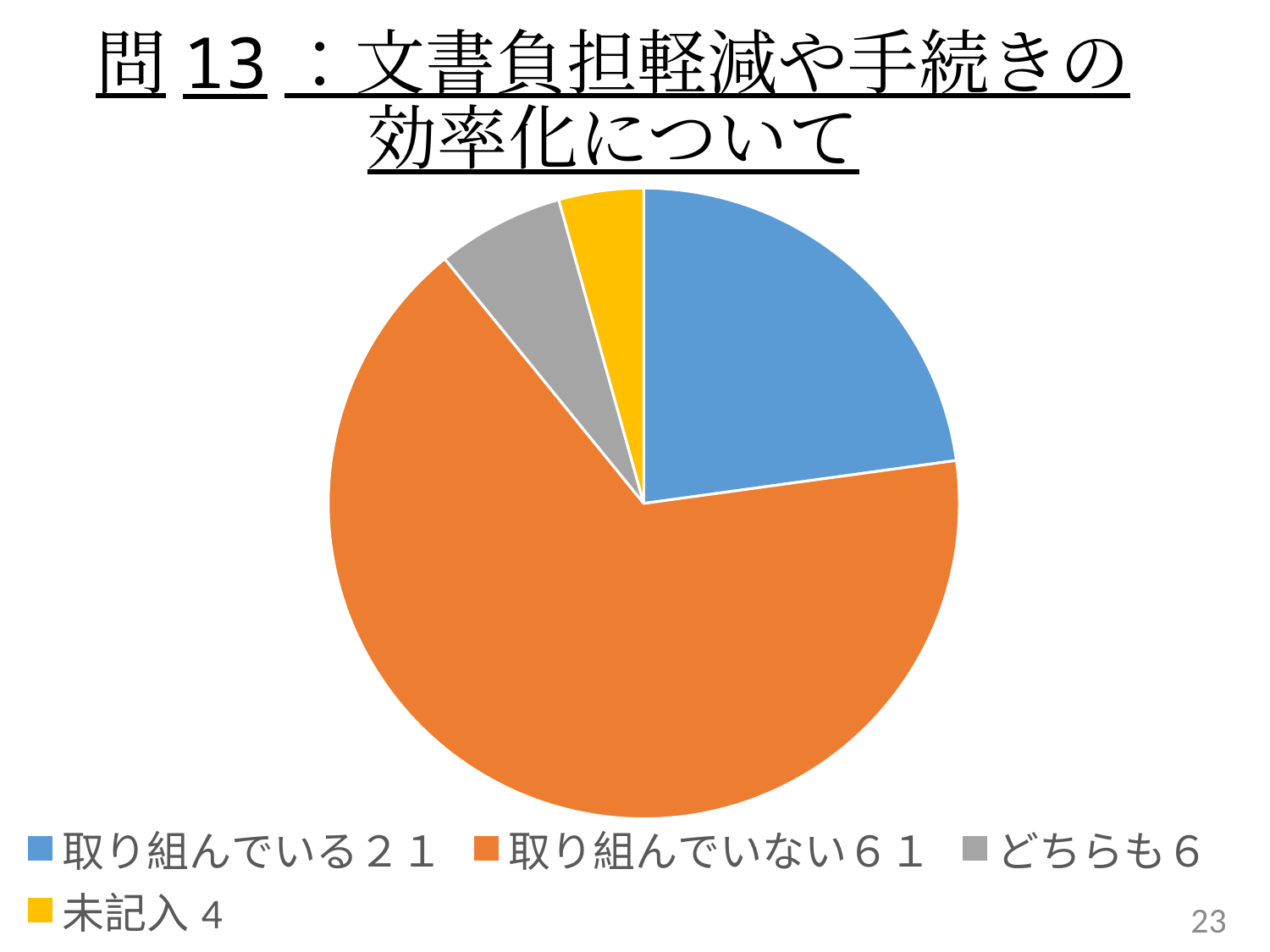
What type of chart is shown on the slide? pie chart Which is larger, the value for 取り組んでいる or the value for どちらも? 取り組んでいる How many categories does the pie chart have? 4 What is the difference between the values for 取り組んでいない and 取り組んでいる? 40 What is the value for 未記入? 4 Which category has the largest slice of the pie? 取り組んでいない What is the value for 取り組んでいない? ６１ What is the title of the slide containing the chart? 問13：文書負担軽減や手続きの効率化について Which category has the smallest slice of the pie? 未記入 What is the value for 取り組んでいる? ２１ What is the value for どちらも? ６ What colour is the slice for 取り組んでいない? orange